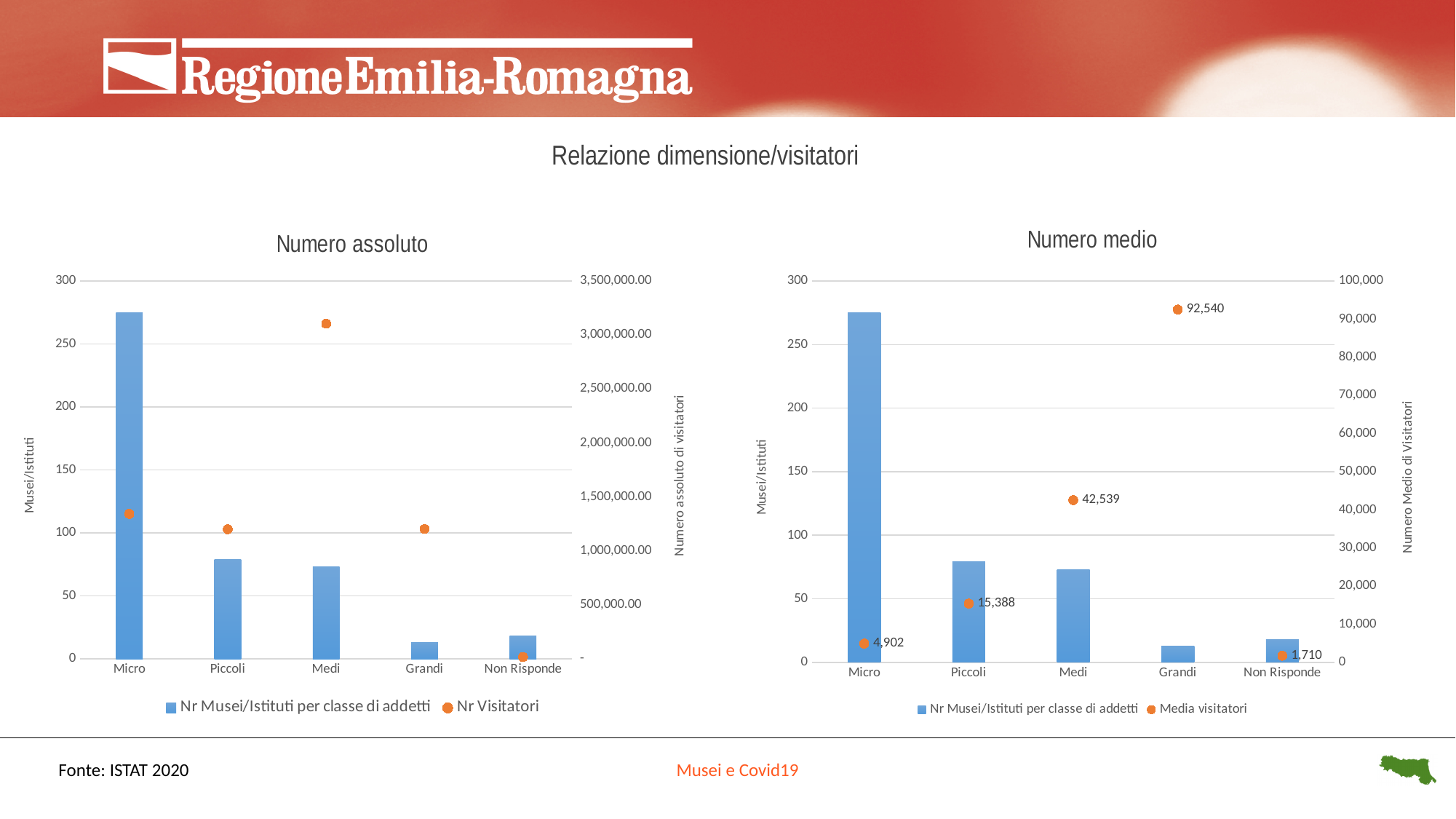
In the 'Numero medio' chart, which category has the highest Media visitatori? Grandi In the 'Numero medio' chart, what is the Media visitatori value for Medi? 42,539 In the 'Numero assoluto' chart, which category has the highest Nr Visitatori? Medi In the 'Numero medio' chart, what is the Media visitatori value for Non Risponde? 1,710 In the 'Numero medio' chart, which has a larger Media visitatori, Micro or Piccoli? Piccoli How many categories are shown on the x axis of the 'Numero medio' chart? 5 In the 'Numero assoluto' chart, which category has the most Musei/Istituti? Micro In the 'Numero assoluto' chart, is the Nr Musei/Istituti value for Micro greater or less than 250? greater In the 'Numero medio' chart, what is the difference between the Media visitatori for Grandi and for Medi? 50,001 In the 'Numero medio' chart, what is the Media visitatori value for Grandi? 92,540 In the 'Numero assoluto' chart, is the Nr Visitatori value for Medi greater or less than 2,500,000.00? greater In the 'Numero medio' chart, which category has the lowest Media visitatori? Non Risponde